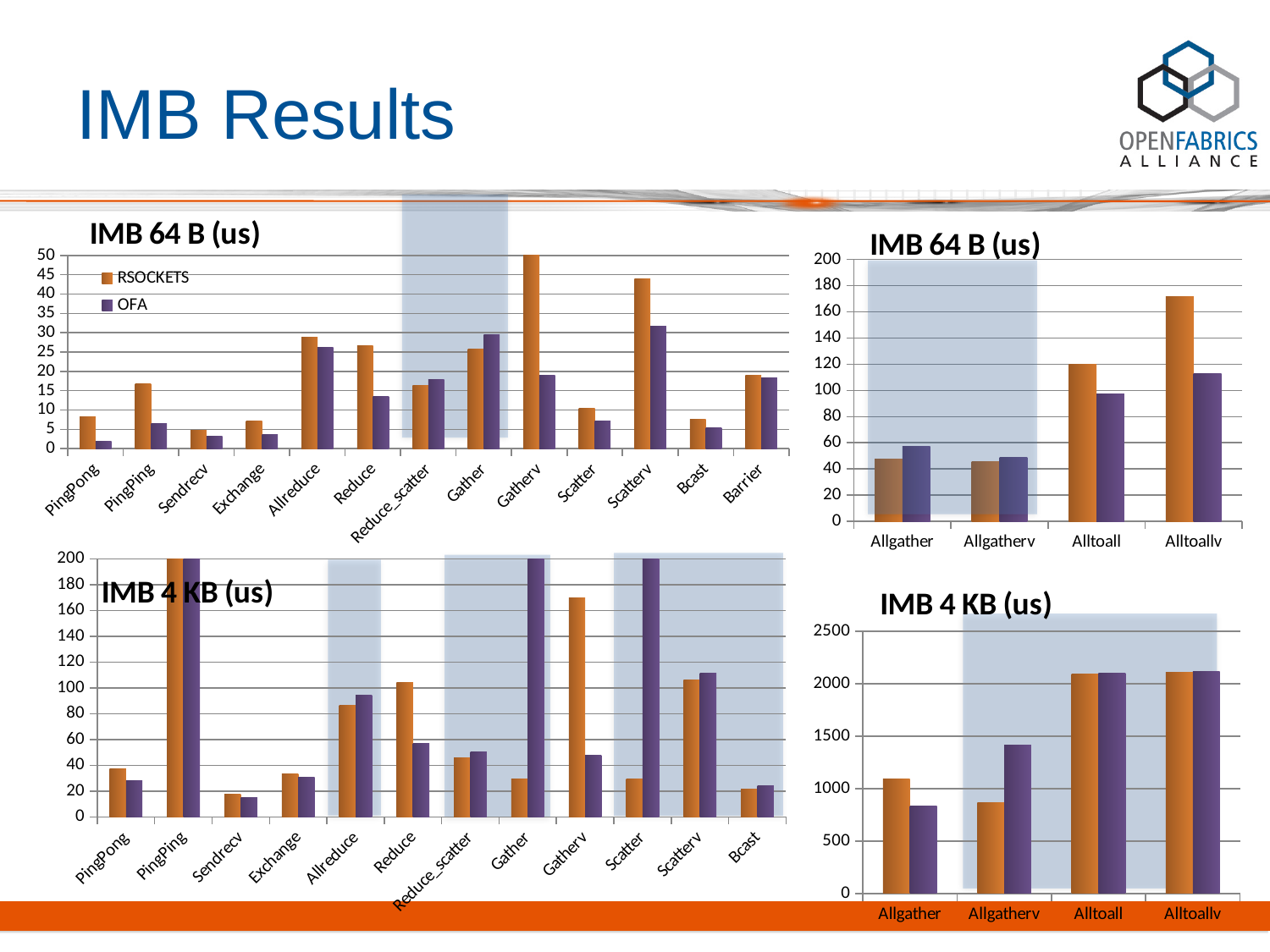
How many categories are shown on the x axis of the bottom-left chart titled 'IMB 4 KB (us)'? 12 How many categories are shown on the x axis of the top-left chart titled 'IMB 64 B (us)'? 13 On the bottom-left chart titled 'IMB 4 KB (us)', is the orange (RSOCKETS) value for Gatherv greater or less than 150? greater On the bottom-right chart titled 'IMB 4 KB (us)', for Allgatherv, which bar is taller: the orange (RSOCKETS) or the purple (OFA)? OFA On the top-left chart titled 'IMB 64 B (us)', which category has the highest RSOCKETS value? Gatherv On the top-right chart titled 'IMB 64 B (us)', is the orange (RSOCKETS) value for Alltoall greater or less than 100? greater On the top-left chart titled 'IMB 64 B (us)', is the RSOCKETS value for Scatterv greater or less than 40? greater On the bottom-left chart titled 'IMB 4 KB (us)', for Reduce, which bar is taller: the orange (RSOCKETS) or the purple (OFA)? RSOCKETS On the top-right chart titled 'IMB 64 B (us)', which category has the tallest bar? Alltoallv On the top-left chart titled 'IMB 64 B (us)', how many series does the legend list? 2 What kind of chart is the bottom-right chart titled 'IMB 4 KB (us)'? bar chart On the top-right chart titled 'IMB 64 B (us)', for Allgather, which bar is taller: the orange (RSOCKETS) or the purple (OFA)? OFA